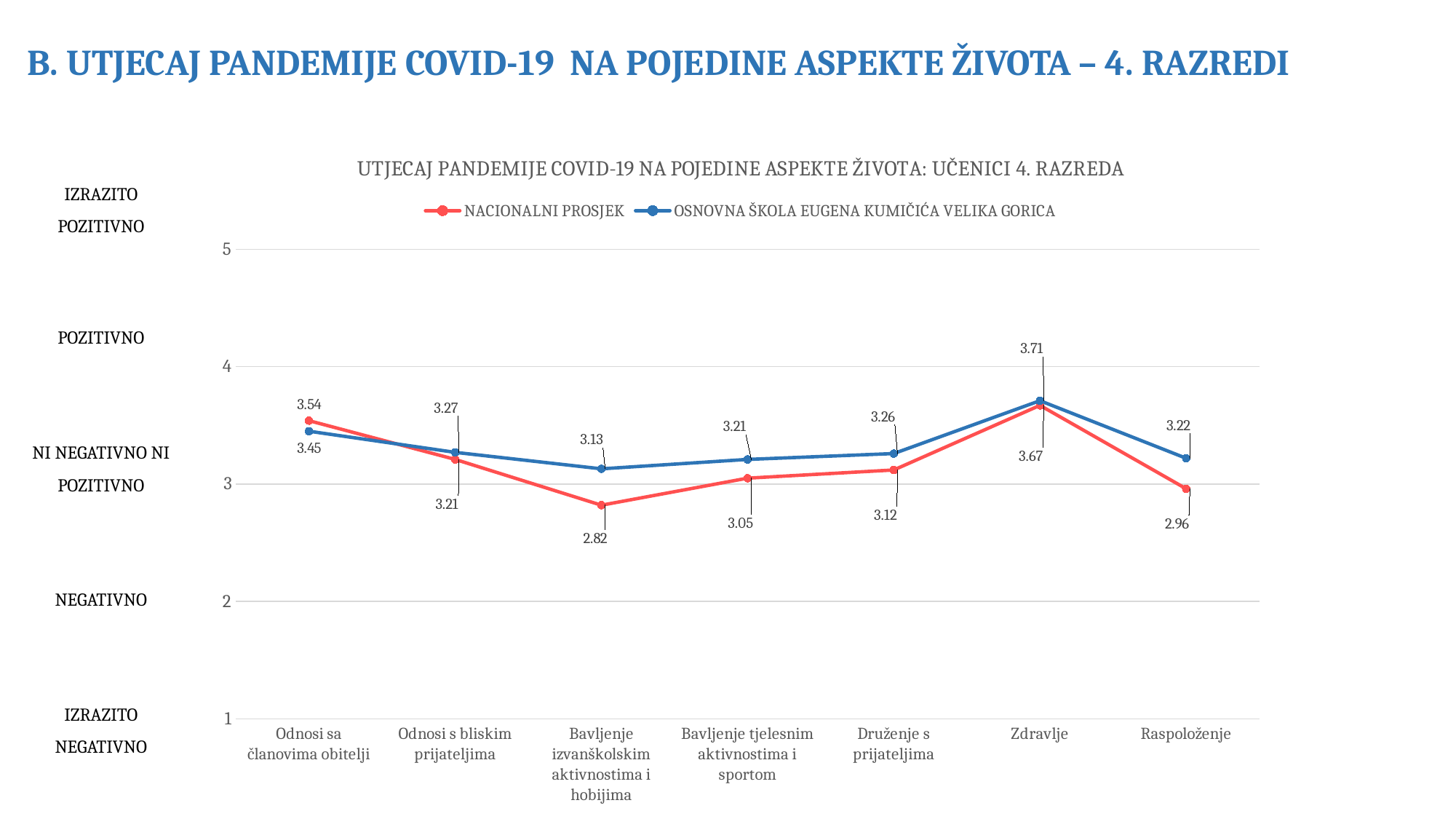
Which category has the lowest value for NACIONALNI PROSJEK? Bavljenje izvanškolskim aktivnostima i hobijima How many series does the legend list? 2 What is the difference between the OSNOVNA ŠKOLA EUGENA KUMIČIĆA VELIKA GORICA and NACIONALNI PROSJEK values for Bavljenje izvanškolskim aktivnostima i hobijima? 0.31 What is the OSNOVNA ŠKOLA EUGENA KUMIČIĆA VELIKA GORICA value for Raspoloženje? 3.22 What kind of chart is shown on the slide? line chart What is the NACIONALNI PROSJEK value for Zdravlje? 3.67 Which category has the highest value for OSNOVNA ŠKOLA EUGENA KUMIČIĆA VELIKA GORICA? Zdravlje Which colour is used for the NACIONALNI PROSJEK line? red Is the NACIONALNI PROSJEK value for Raspoloženje greater or less than 3? less For Odnosi sa članovima obitelji, which series has the larger value, NACIONALNI PROSJEK or OSNOVNA ŠKOLA EUGENA KUMIČIĆA VELIKA GORICA? NACIONALNI PROSJEK What is the NACIONALNI PROSJEK value for Bavljenje izvanškolskim aktivnostima i hobijima? 2.82 How many categories are shown on the x axis? 7